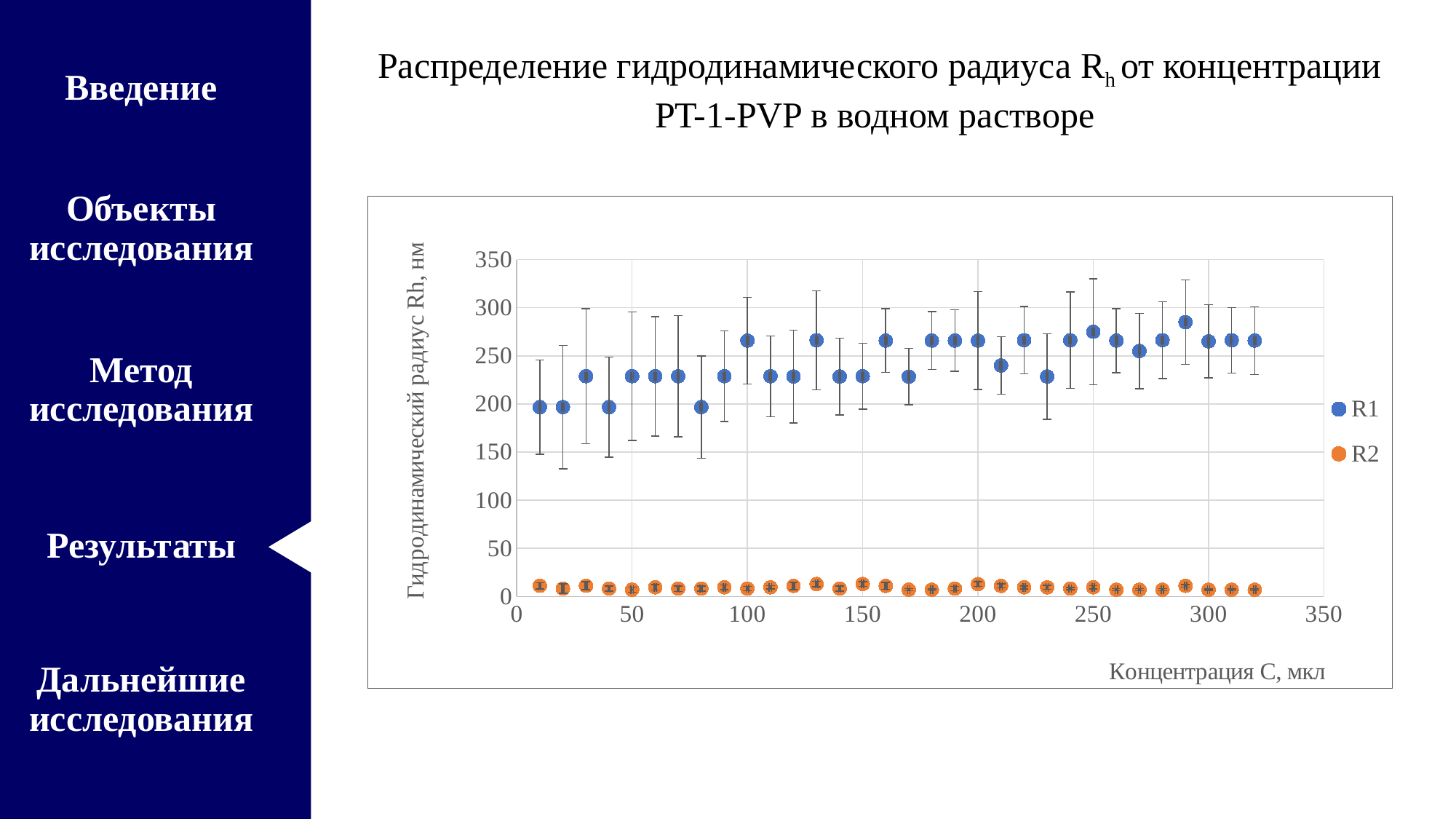
Which series has larger values at concentration 150, R1 or R2? R1 Is the R1 value at concentration 100 greater or less than 250? greater What kind of chart is shown on the slide? scatter chart Is the R2 value at concentration 200 greater or less than 50? less How many series does the legend list? 2 How many data points does series R1 have? 32 What is the title of the x axis? Концентрация C, мкл Do the R1 values generally rise or fall as concentration increases from 10 to 320? rise Is the R1 value at concentration 10 greater or less than 150? greater At which concentration does series R1 reach its highest value? 290 What are the names of the two series in the legend? R1 and R2